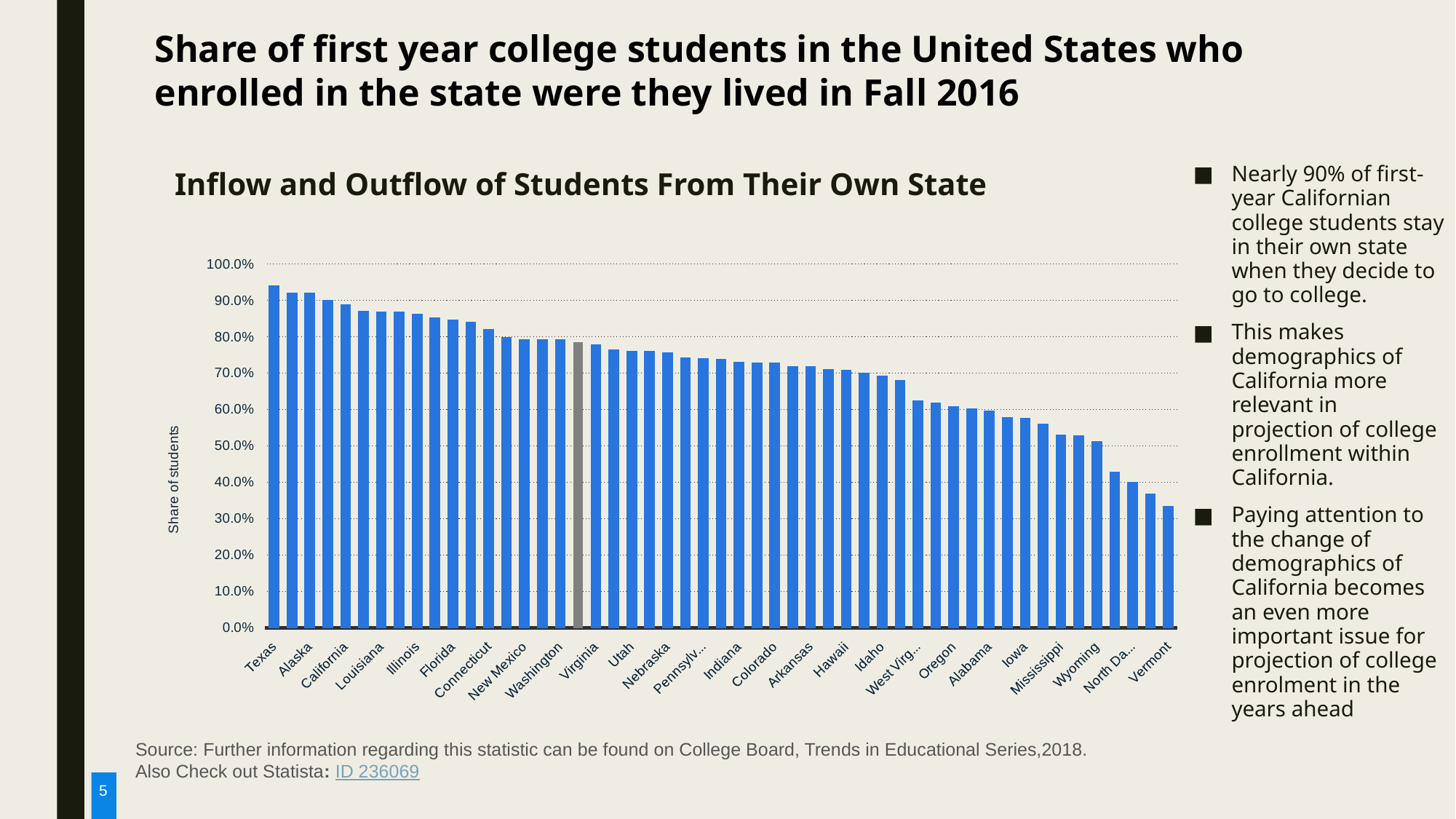
Is the value for Vermont greater or less than 40.0%? less Is the value for Texas greater or less than 90.0%? greater Which state has the lowest share of students in the chart? Vermont Do the values rise or fall moving from left to right along the x axis? Fall Which has a larger share of students, Florida or Iowa? Florida Is the value for Colorado greater or less than 70.0%? greater Which has a larger share of students, Oregon or Alaska? Alaska What kind of chart is shown on the slide? Bar chart Which state has the highest share of students in the chart? Texas What is the title of the chart? Inflow and Outflow of Students From Their Own State